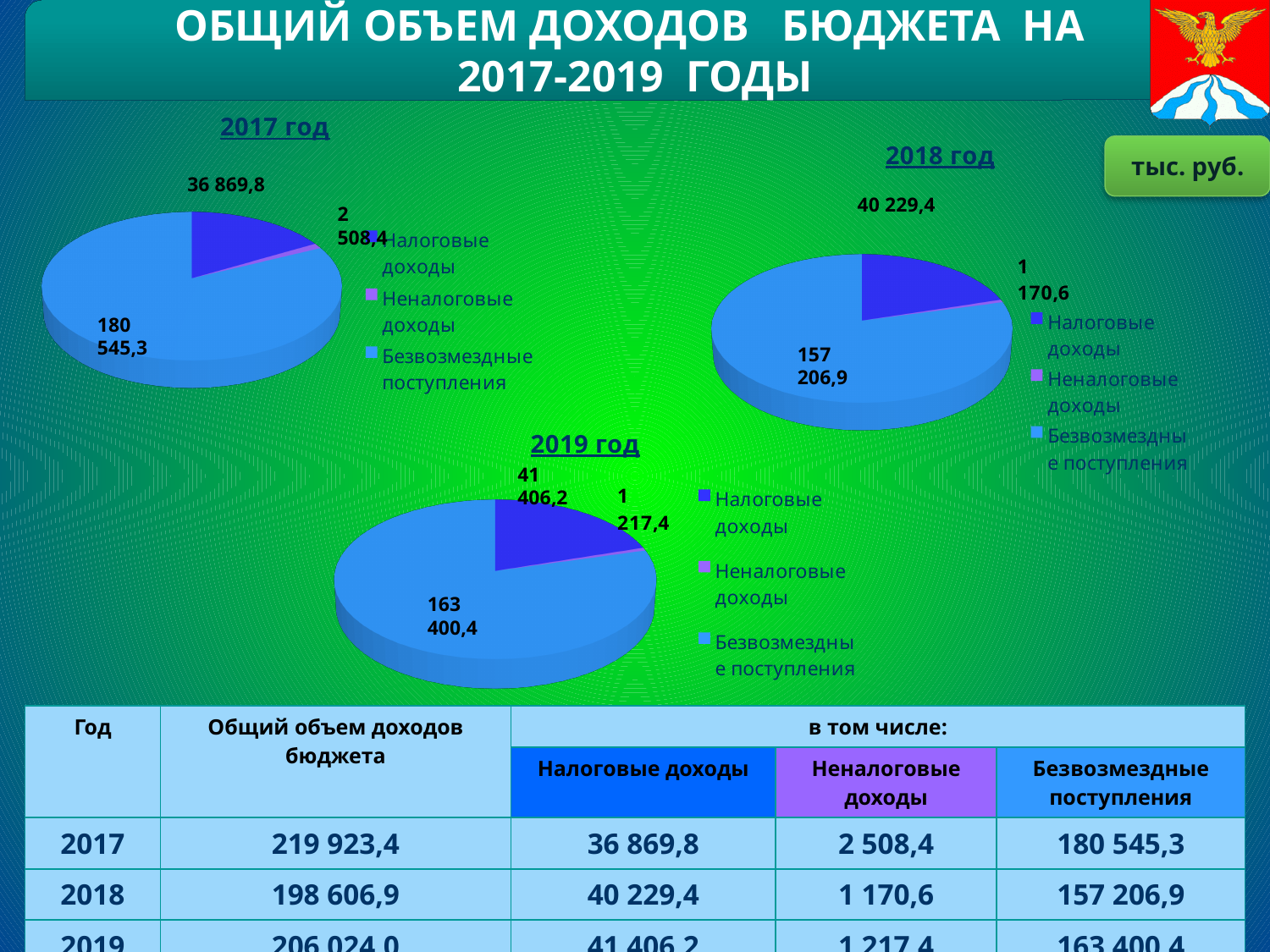
On the 2017 год pie chart, what is the value for Налоговые доходы? 36 869,8 On the 2019 год pie chart, what is the difference between Безвозмездные поступления and Налоговые доходы? 121 994,2 On the 2017 год pie chart, what is the difference between Налоговые доходы and Неналоговые доходы? 34 361,4 On the 2019 год pie chart, what is the value for Неналоговые доходы? 1 217,4 On the 2017 год pie chart, which category has the largest slice? Безвозмездные поступления How many entries does the legend of the 2017 год pie chart list? 3 How many slices does the 2018 год pie chart have? 3 On the 2018 год pie chart, what is the value for Безвозмездные поступления? 157 206,9 On the 2018 год pie chart, what is the value for Налоговые доходы? 40 229,4 On the 2018 год pie chart, which is larger: Налоговые доходы or Неналоговые доходы? Налоговые доходы On the 2019 год pie chart, which category has the smallest slice? Неналоговые доходы What kind of chart is used for the 2019 год data? Pie chart